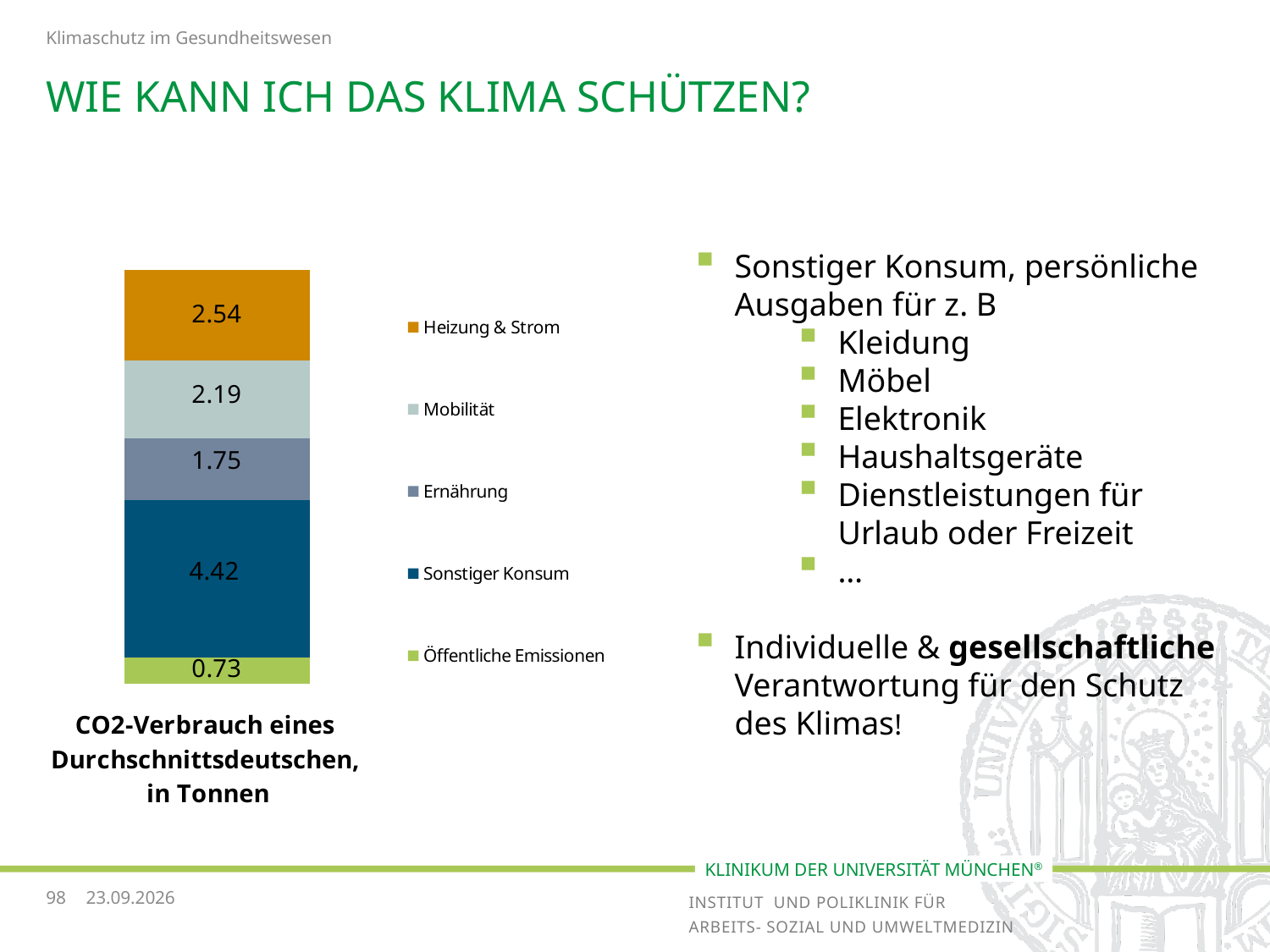
How many series does the legend list? 5 How many segments does the stacked bar contain? 5 Which segment of the stacked bar has the highest value? Sonstiger Konsum What kind of chart is shown on the slide? Stacked bar chart Which is larger, the value for Mobilität or the value for Ernährung? Mobilität What value is shown for Öffentliche Emissionen? 0.73 What value is shown for Sonstiger Konsum in the CO2-Verbrauch chart? 4.42 What is the difference between the values for Heizung & Strom and Mobilität? 0.35 What is the total of all segments in the stacked bar? 11.63 Which segment of the stacked bar has the lowest value? Öffentliche Emissionen What value is shown for Heizung & Strom? 2.54 What value is shown for Ernährung? 1.75